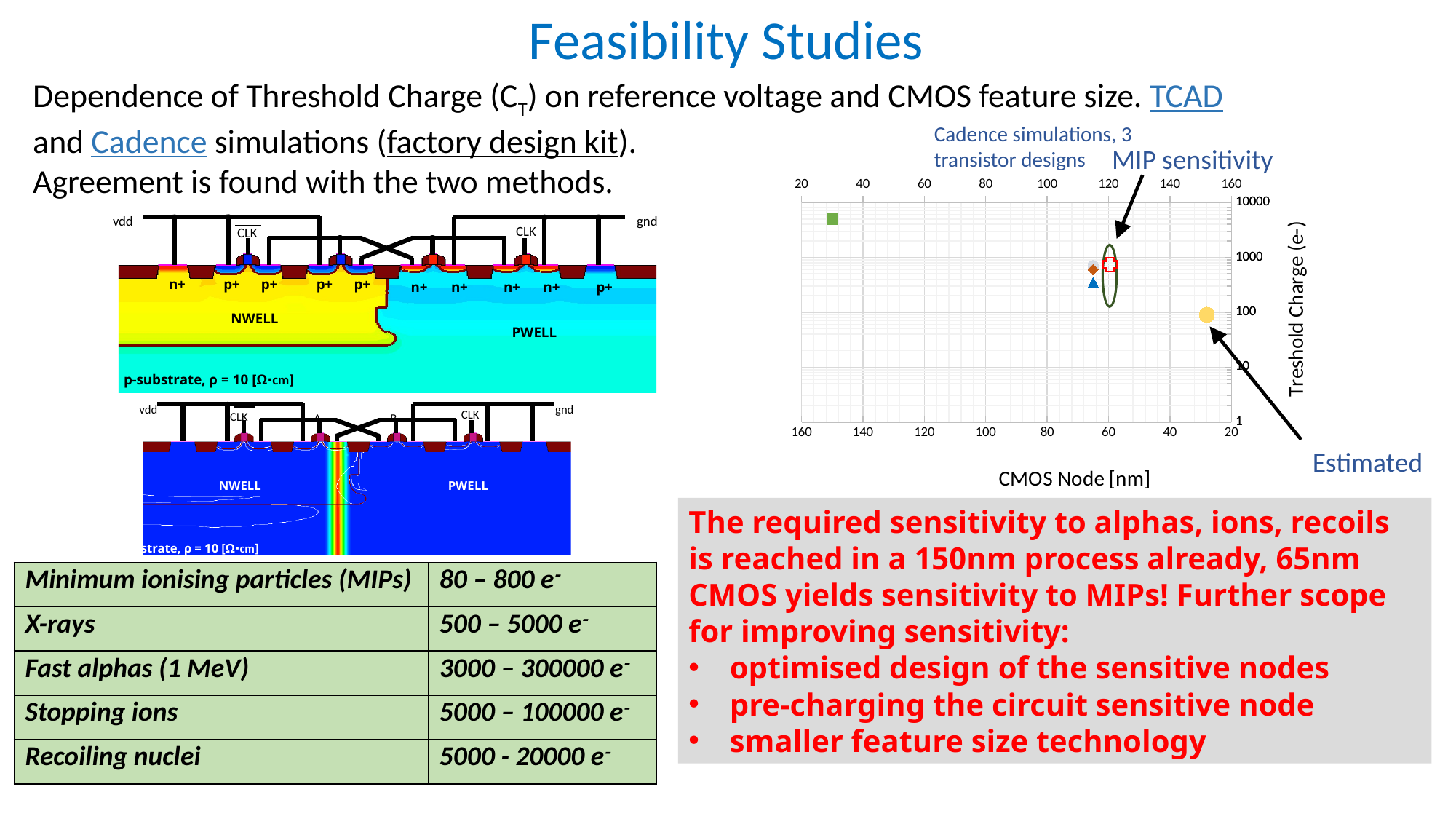
In the scatter chart, does the threshold charge rise or fall as the CMOS node decreases from 160 nm to 20 nm along the bottom axis? fall In the scatter chart, is the threshold charge of the red cross point (near 65 nm, circled as MIP sensitivity) greater or less than 10000? less What is the title of the vertical axis of the scatter chart? Treshold Charge (e-) What kind of chart is shown on the right of the slide? scatter chart What is the title of the horizontal axis of the scatter chart? CMOS Node [nm] In the scatter chart, is the threshold charge of the blue triangle point (near 65 nm) greater or less than 100? greater In the scatter chart, is the threshold charge of the green square point (near 150 nm) greater or less than 1000? greater In the scatter chart, which point has the highest threshold charge: the green square or the yellow circle? the green square In the scatter chart, which marker has the highest threshold charge? the green square (near 150 nm) In the scatter chart, which marker has the lowest threshold charge? the yellow circle (Estimated, near 30 nm)